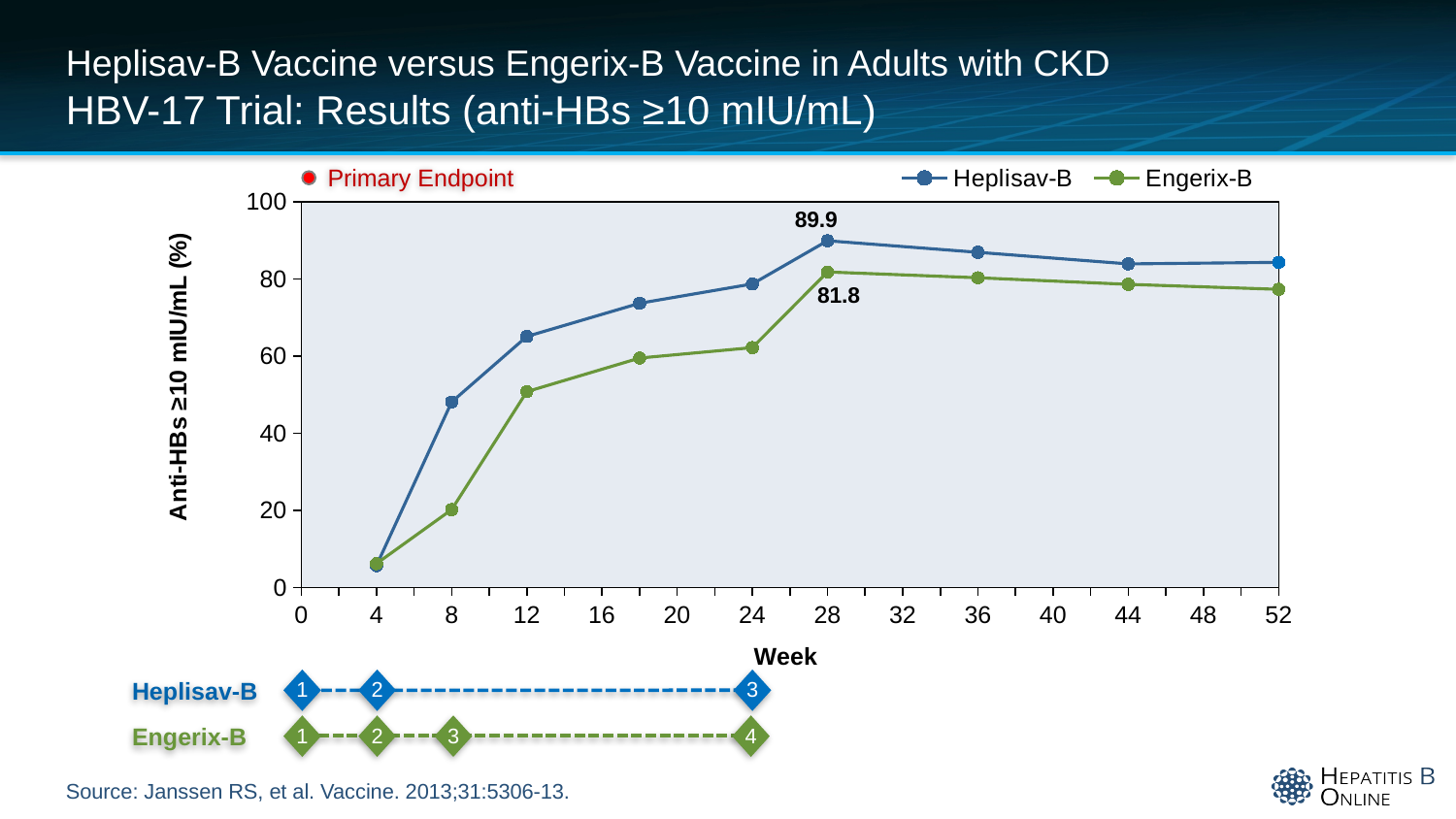
What kind of chart is shown on the slide? Line chart At week 28, which series has the higher value, Heplisav-B or Engerix-B? Heplisav-B At which week does the Heplisav-B series reach its highest value? Week 28 What is the label on the y axis of the chart? Anti-HBs ≥10 mIU/mL (%) Is the value for Engerix-B at week 4 greater or less than 20? less Is the value for Engerix-B at week 8 greater or less than 40? less Is the value for Heplisav-B at week 12 greater or less than 60? greater What is the value for Engerix-B at week 28? 81.8 How many series does the legend list? 2 What is the value for Heplisav-B at week 28? 89.9 What is the difference between the Heplisav-B and Engerix-B values at week 28? 8.1